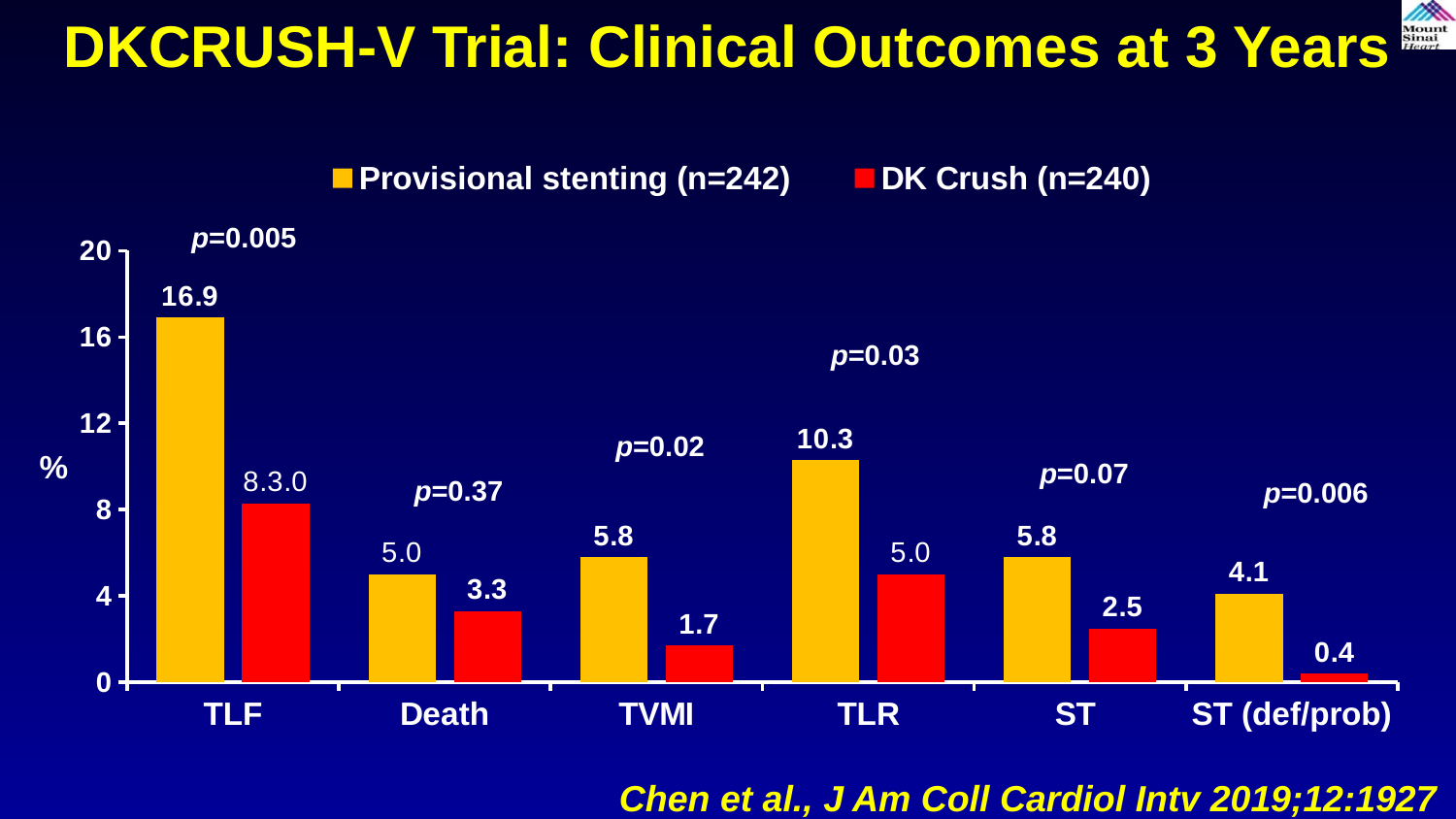
Which category has the lowest value for DK Crush? ST (def/prob) How many series does the legend list? 2 Which is larger for Death: Provisional stenting or DK Crush? Provisional stenting What is the value for DK Crush for ST (def/prob)? 0.4 Is the value for Provisional stenting for TLR greater or less than 8? greater How many outcome categories are shown on the x axis? 6 Which category has the highest value for Provisional stenting? TLF What is the value for DK Crush for TLR? 5.0 What p-value is shown above the TLF bars? p=0.005 What is the value for Provisional stenting for TLF? 16.9 What type of chart is shown on the slide? bar chart What is the difference between Provisional stenting and DK Crush for TVMI? 4.1